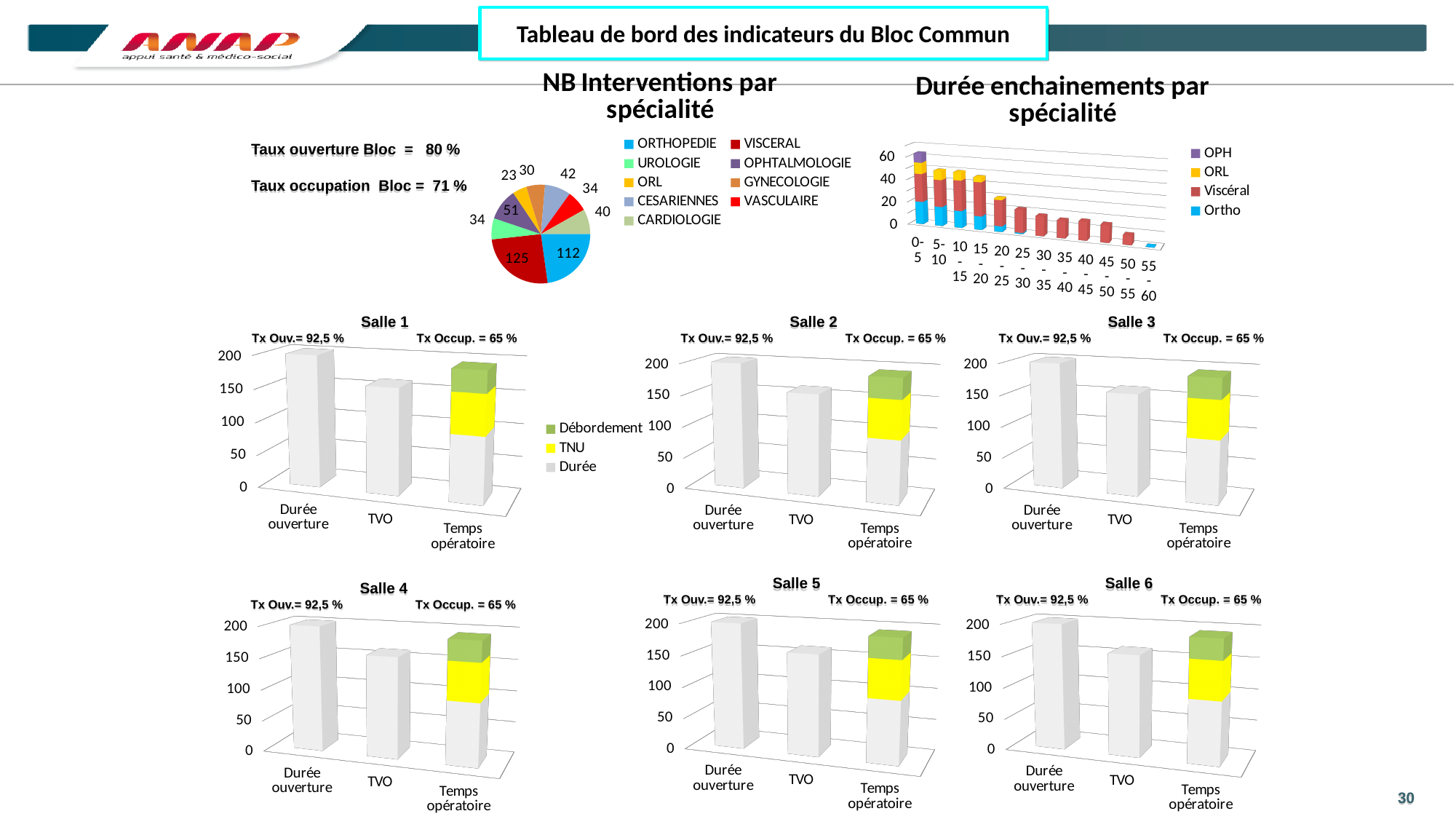
In the pie chart 'NB Interventions par spécialité', which specialty has the lowest number of interventions? ORL In the 'Salle 1' chart, is the value for Durée ouverture greater or less than 150? greater In the pie chart 'NB Interventions par spécialité', which specialty has the highest number of interventions? VISCERAL What kind of chart is 'Durée enchainements par spécialité'? Stacked bar chart In the pie chart 'NB Interventions par spécialité', what is the value for VISCERAL? 125 In the 'Salle 4' chart, which is larger, Durée ouverture or TVO? Durée ouverture In the chart 'Durée enchainements par spécialité', do the bar heights rise or fall from the 0-5 category to the 55-60 category? Fall In the pie chart 'NB Interventions par spécialité', what is the value for OPHTALMOLOGIE? 51 How many series does the legend of the chart 'Durée enchainements par spécialité' list? 4 How many specialties are listed in the legend of the pie chart 'NB Interventions par spécialité'? 9 In the pie chart 'NB Interventions par spécialité', what is the value for ORTHOPEDIE? 112 In the pie chart 'NB Interventions par spécialité', what is the difference between the VISCERAL and ORTHOPEDIE values? 13